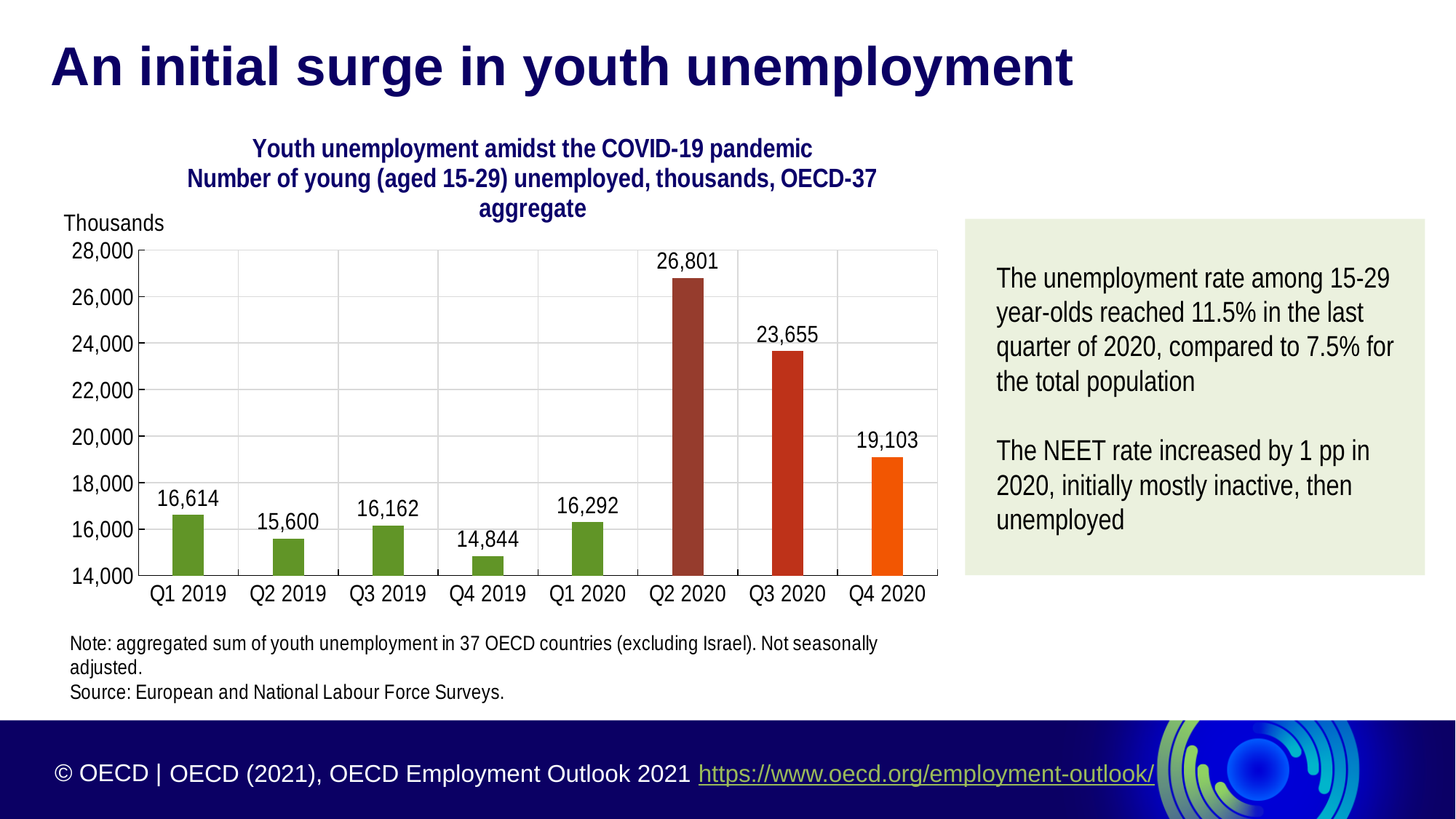
What is the number of young unemployed (thousands) in Q2 2020? 26,801 Is the value for Q3 2020 greater or less than 22,000? greater Which quarter has the highest number of young unemployed? Q2 2020 What unit is indicated on the vertical axis of the chart? Thousands What is the difference between the values for Q1 2020 and Q4 2019? 1,448 Which quarter has the lowest number of young unemployed? Q4 2019 How many quarters are shown on the x axis? 8 What is the difference between the values for Q2 2020 and Q3 2020? 3,146 Which is larger, the value for Q1 2019 or the value for Q3 2019? Q1 2019 What is the value shown for Q4 2019? 14,844 What kind of chart is shown on the slide? Bar chart What is the value shown for Q4 2020? 19,103